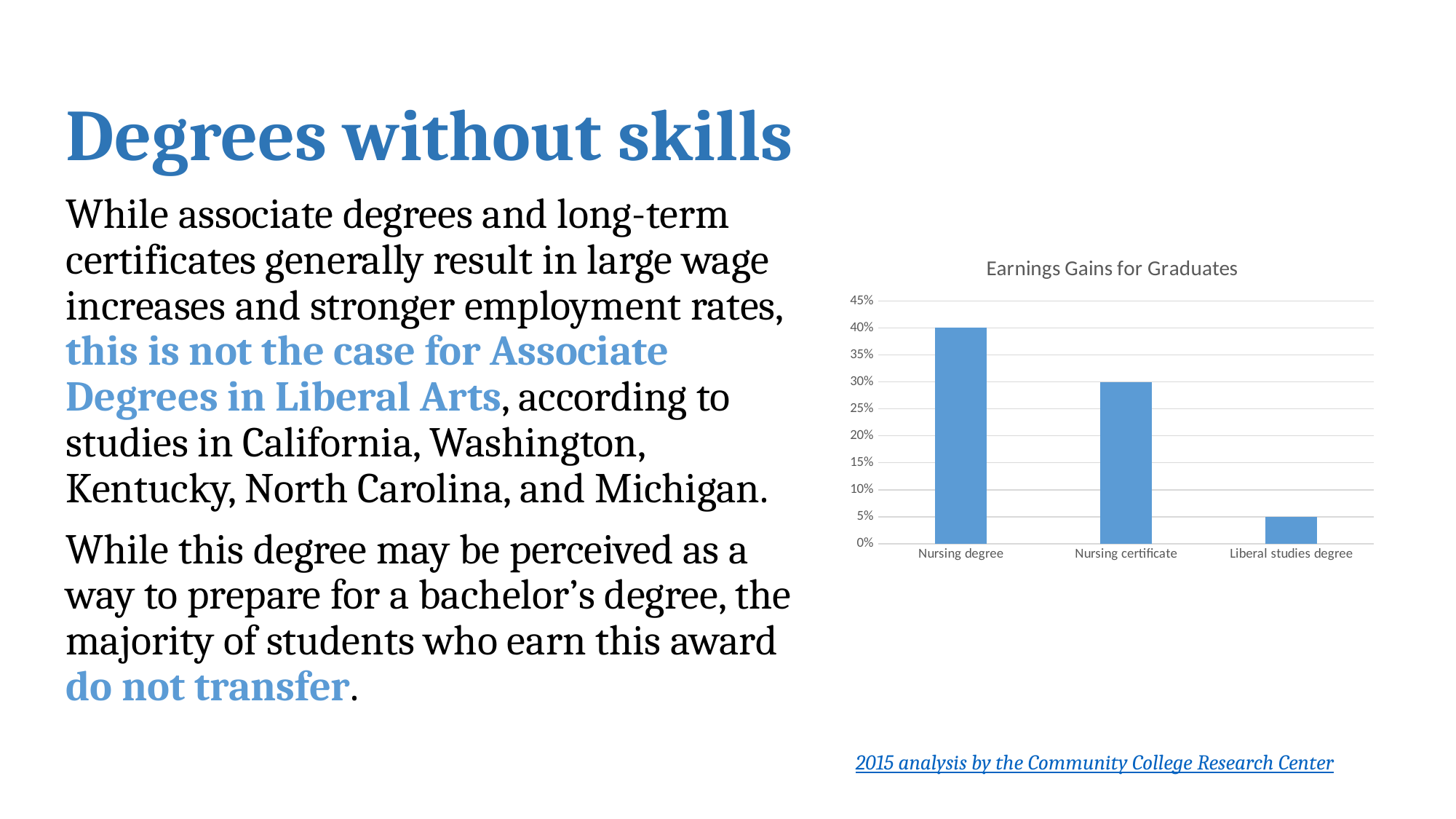
What is the earnings gain for Nursing degree? 40% Do the values rise or fall from left to right across the categories? fall What type of chart is shown on the slide? bar chart What is the title of the chart? Earnings Gains for Graduates Which category has the lowest earnings gain? Liberal studies degree Which has a larger earnings gain, Nursing certificate or Liberal studies degree? Nursing certificate What is the difference between the earnings gain for Nursing certificate and Liberal studies degree? 25% Which category has the highest earnings gain? Nursing degree What is the earnings gain for Nursing certificate? 30% How many categories are shown in the chart? 3 What is the earnings gain for Liberal studies degree? 5% What is the difference between the earnings gain for Nursing degree and Nursing certificate? 10%